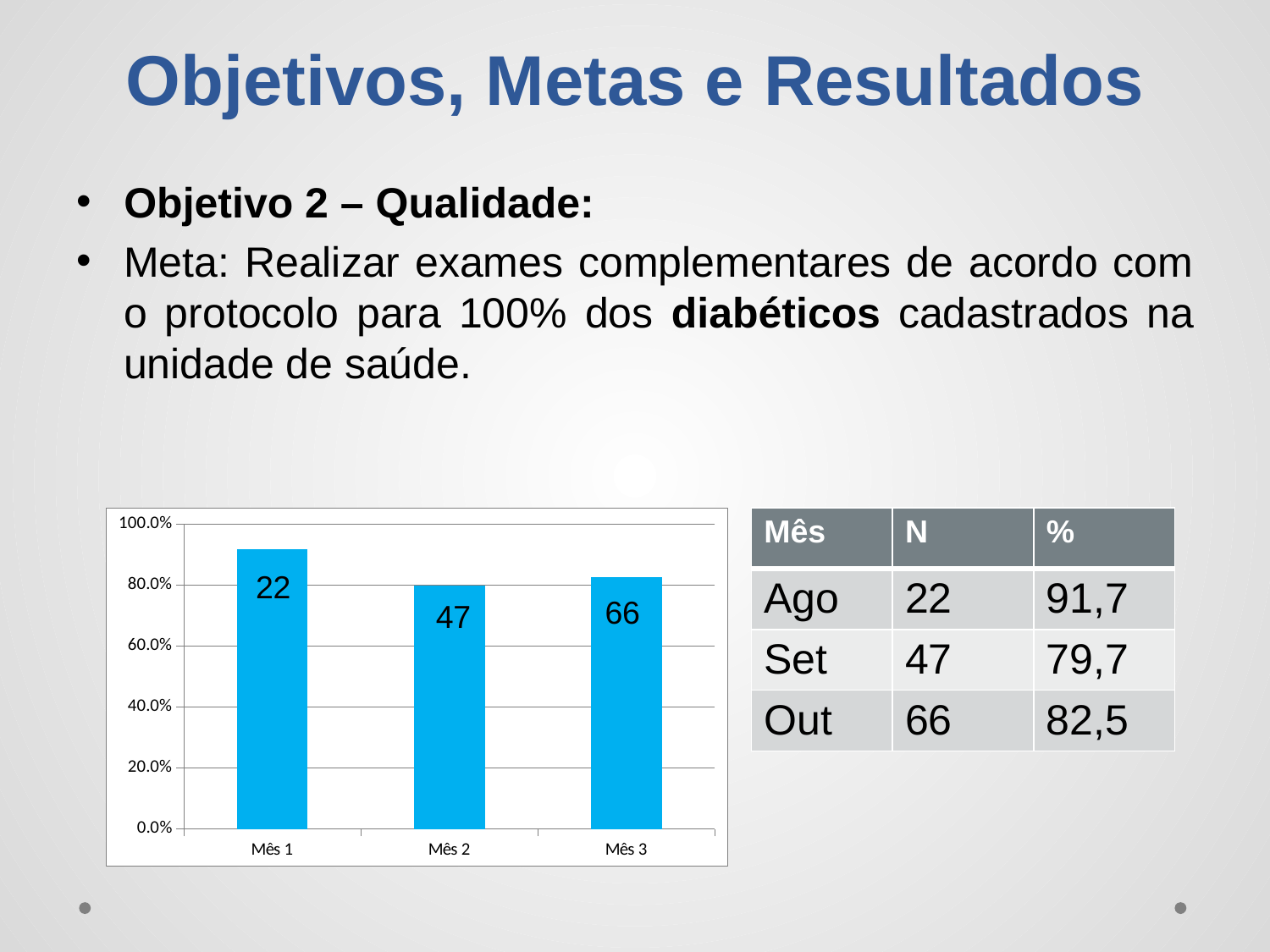
What is the difference between the data labels printed on the bars for Mês 3 and Mês 1? 44 What kind of chart is shown on the slide? bar chart Is the value for Mês 3 greater or less than 100.0%? less Is the value for Mês 2 greater or less than 60.0%? greater What data label is printed on the bar for Mês 1? 22 What data label is printed on the bar for Mês 3? 66 Is the value for Mês 1 greater or less than 80.0%? greater What data label is printed on the bar for Mês 2? 47 What is the highest value shown on the chart's vertical axis? 100.0% Is the bar for Mês 1 taller or shorter than the bar for Mês 2? taller Which month has the tallest bar in the chart? Mês 1 How many bars are shown in the chart? 3